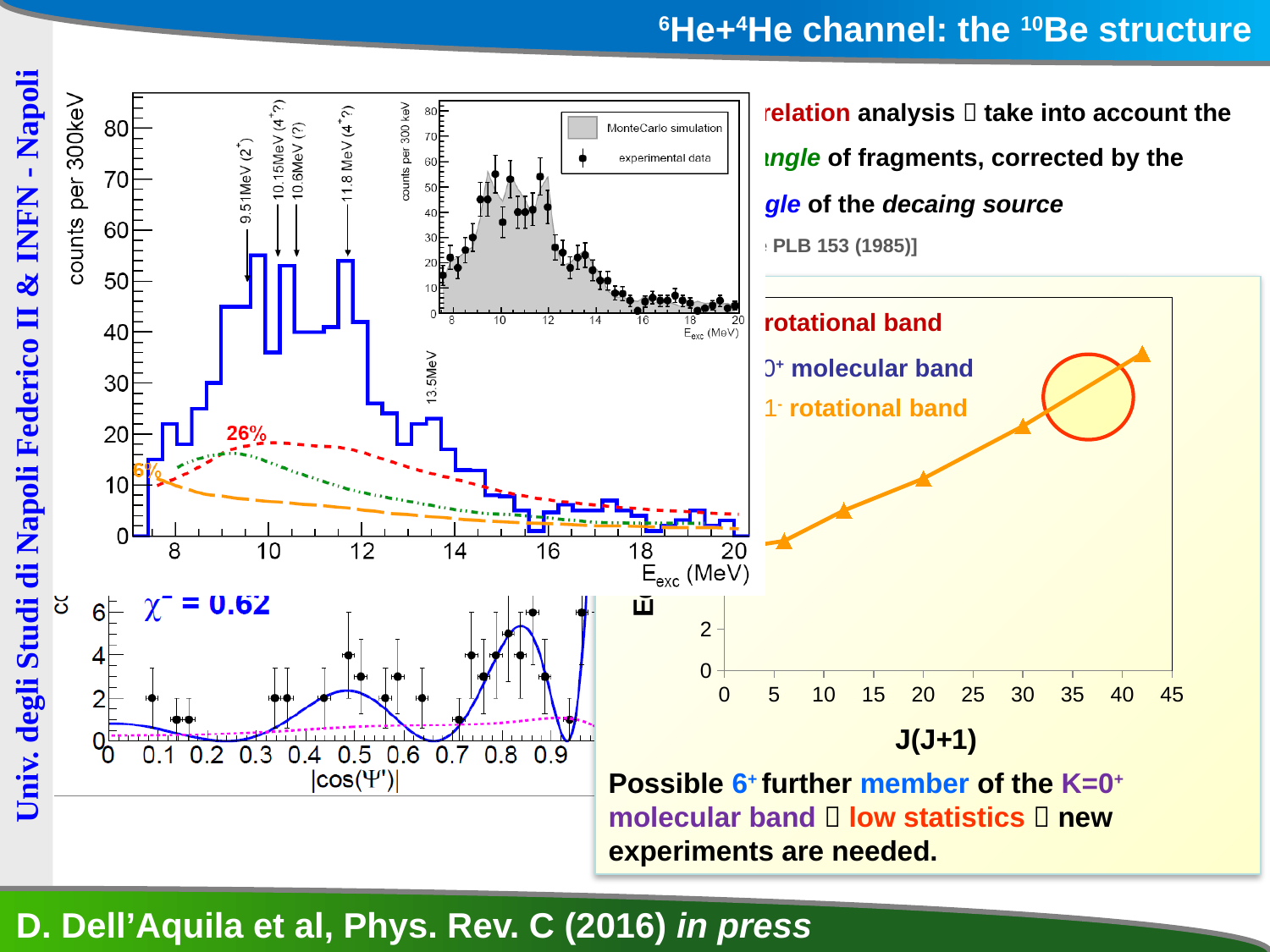
On the inset histogram, what does the grey shaded area represent according to the legend? MonteCarlo simulation On the large histogram at the top left, what percentage is written next to the red dashed curve? 26% On the large histogram at the top left, is the peak count near 10 MeV greater or less than 40? greater On the right-hand chart versus J(J+1), how many orange triangle data points are plotted? 5 On the bottom-left plot versus |cos(Ψ')|, what value of χ² is printed? 0.62 On the large histogram at the top left, what energy is labelled for the 2+ state? 9.51MeV On the inset histogram, how many entries does the legend list? 2 On the large histogram at the top left, what percentage is written next to the orange dashed curve? 6% On the right-hand chart, what is the largest tick value shown on the J(J+1) axis? 45 On the bottom-left plot versus |cos(Ψ')|, is the data point near |cos(Ψ')| = 0.1 greater or less than 4? less On the large histogram at the top left, what is the label of the x axis? E_exc (MeV) On the right-hand chart versus J(J+1), do the orange triangle points rise or fall as J(J+1) increases? rise